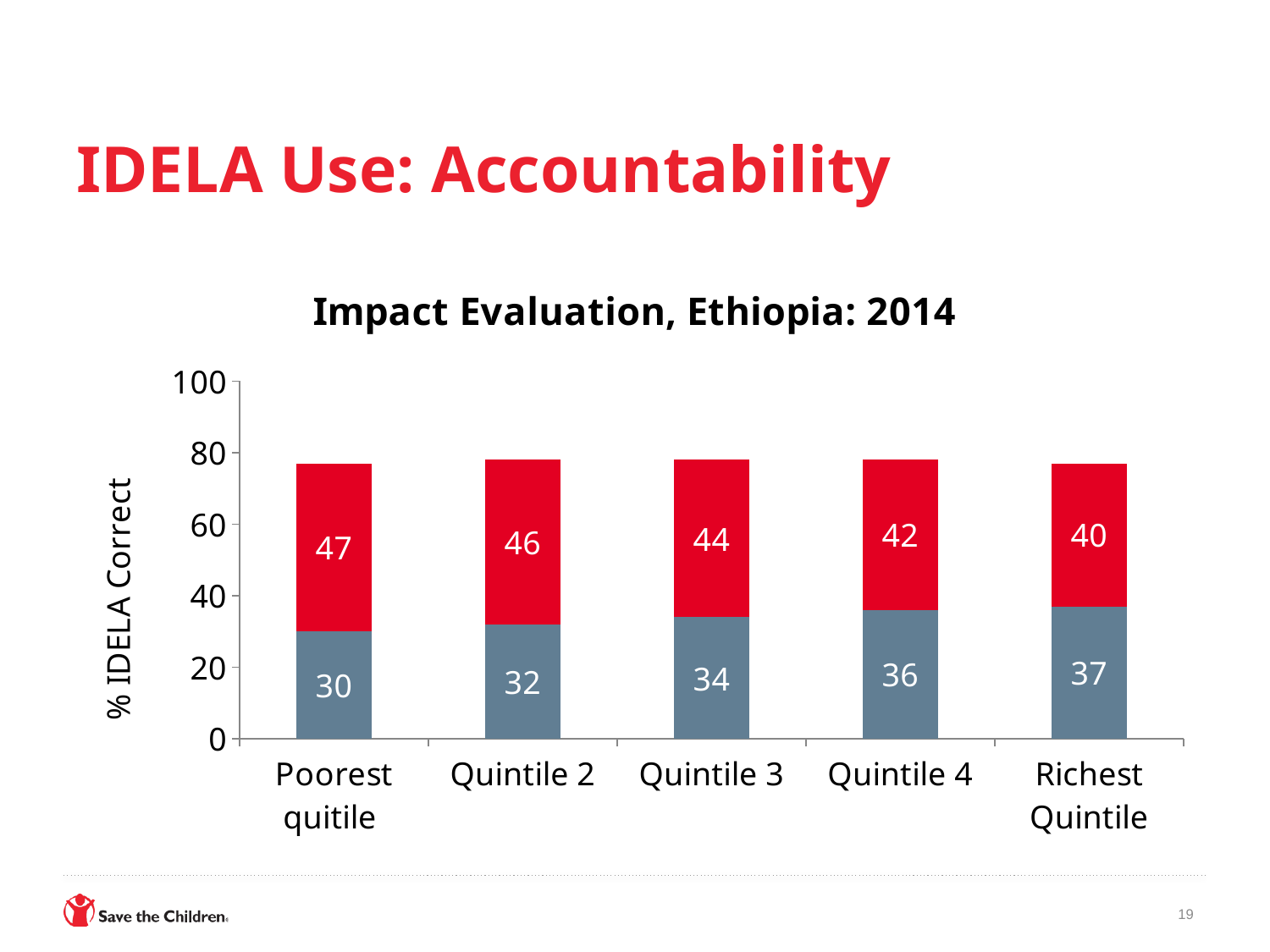
What is the difference between the red segment values for the Poorest quitile and the Richest Quintile? 7 Do the grey (bottom) segment values rise or fall from the Poorest quitile to the Richest Quintile? Rise Is the grey (bottom) segment value larger for Quintile 2 or Quintile 4? Quintile 4 What kind of chart is shown on the slide? Stacked bar chart Which category has the lowest red (top) segment value? Richest Quintile Which category has the highest grey (bottom) segment value? Richest Quintile What is the value of the red (top) segment for the Richest Quintile? 40 How many categories are shown on the x axis? 5 What is the total height of the stacked bar for the Poorest quitile? 77 What is the total height of the stacked bar for Quintile 2? 78 What is the value of the grey (bottom) segment for Quintile 3? 34 What is the value of the red (top) segment for the Poorest quitile? 47